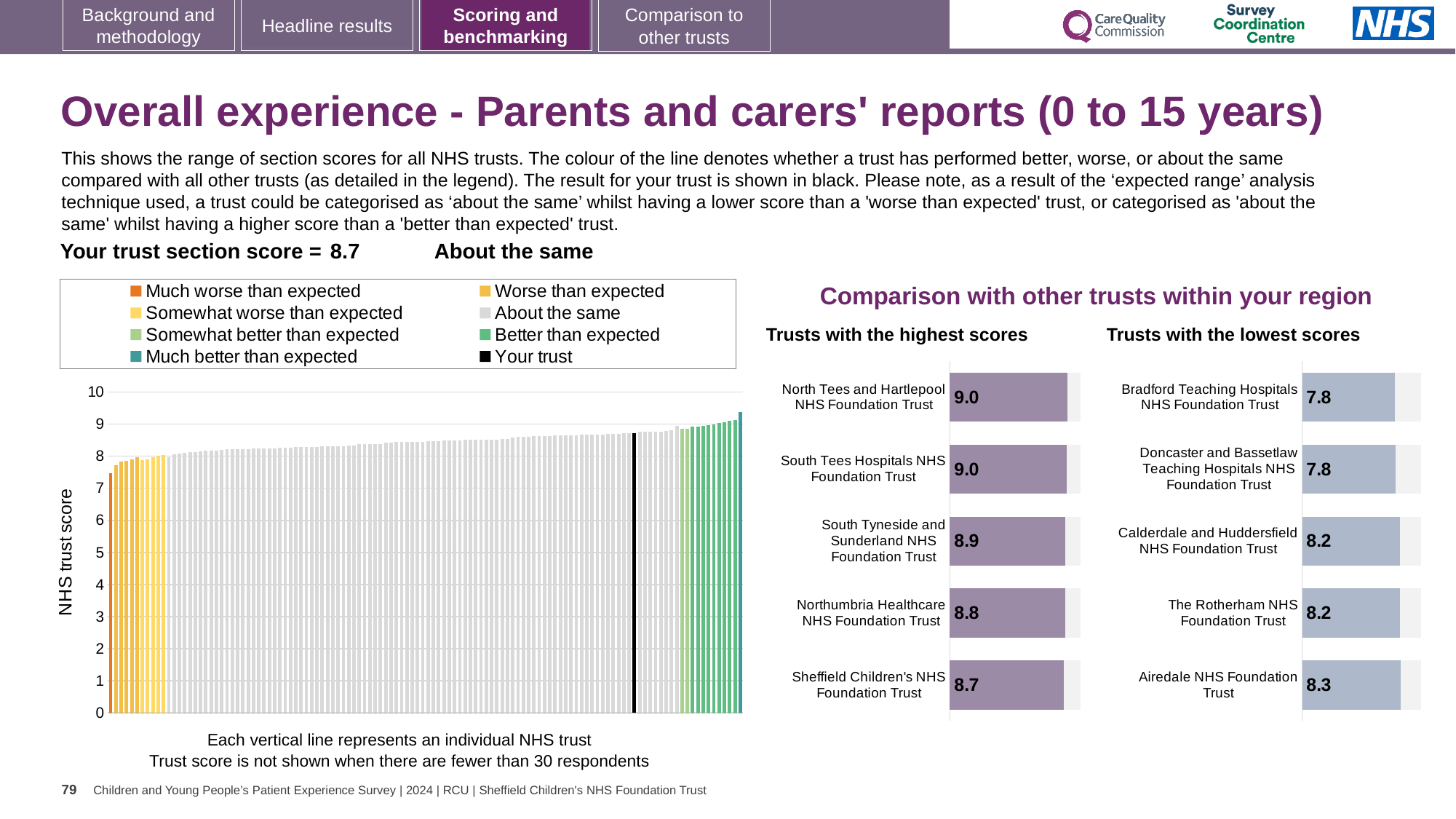
In the large chart on the left, do the trust scores rise or fall from left to right? rise In the 'Trusts with the lowest scores' chart, which trust has the highest score? Airedale NHS Foundation Trust In the 'Trusts with the highest scores' chart, which trust has the lowest score? Sheffield Children's NHS Foundation Trust How many trusts are shown in the 'Trusts with the highest scores' chart? 5 In the large chart on the left, is the value for the lowest-scoring trust (the leftmost bar) greater or less than 8? less In the 'Trusts with the lowest scores' chart, what is the score for Calderdale and Huddersfield NHS Foundation Trust? 8.2 In the 'Trusts with the lowest scores' chart, what is the difference between the scores of Airedale NHS Foundation Trust and Bradford Teaching Hospitals NHS Foundation Trust? 0.5 In the 'Trusts with the highest scores' chart, what is the difference between the scores of North Tees and Hartlepool NHS Foundation Trust and Sheffield Children's NHS Foundation Trust? 0.3 In the 'Trusts with the lowest scores' chart, which has the larger score: The Rotherham NHS Foundation Trust or Airedale NHS Foundation Trust? Airedale NHS Foundation Trust In the 'Trusts with the highest scores' chart, what is the score for Northumbria Healthcare NHS Foundation Trust? 8.8 How many entries does the legend of the large chart on the left list? 8 In the large chart on the left, is the value for the highest-scoring trust (the rightmost bar) greater or less than 9? greater